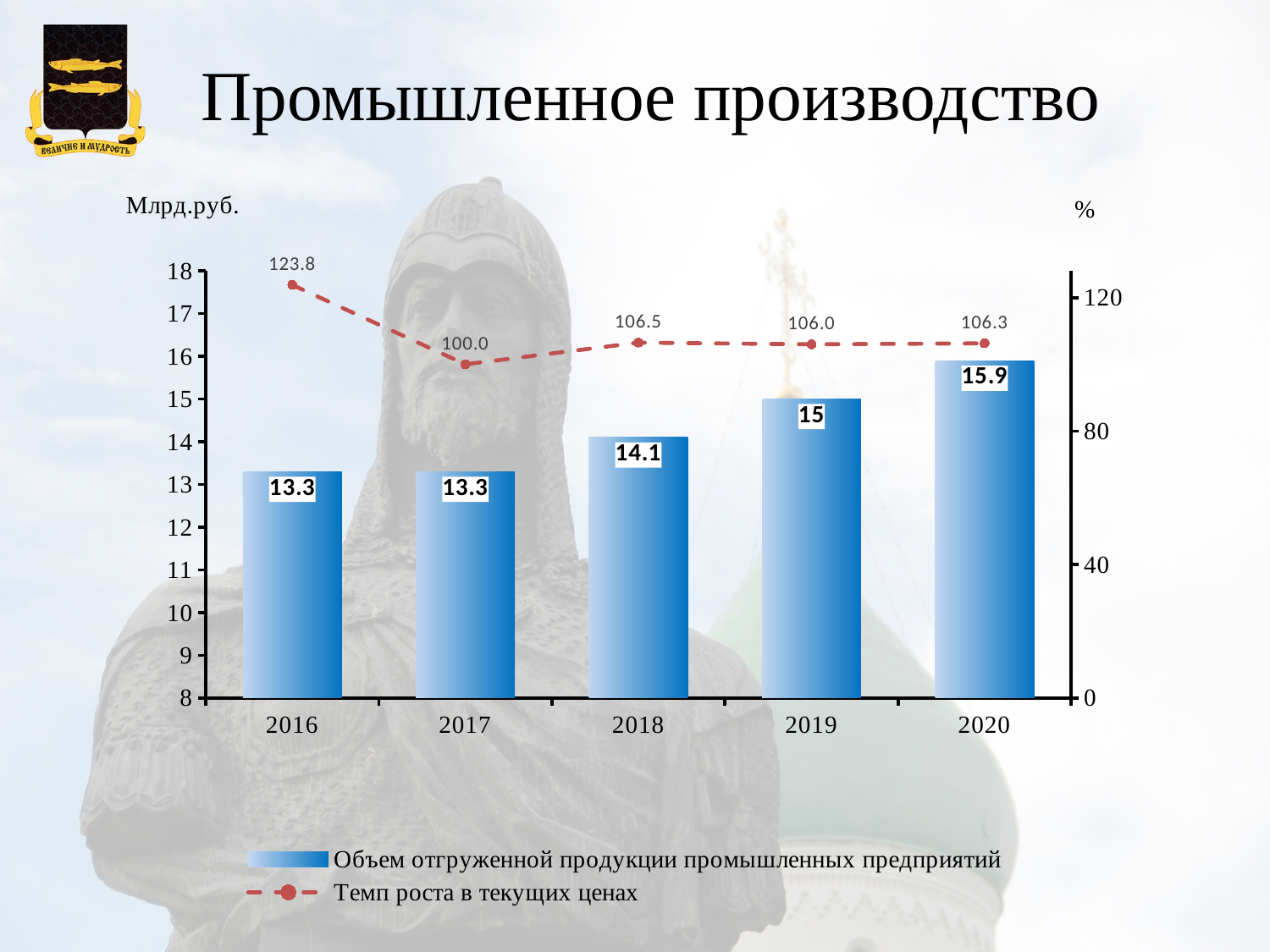
How many series does the legend list? 2 How many years are shown on the x axis? 5 What kind of chart is used for 'Объем отгруженной продукции промышленных предприятий'? bar chart What is the value of 'Темп роста в текущих ценах' for 2018? 106.5 What is the difference between the 'Объем отгруженной продукции промышленных предприятий' values for 2020 and 2016? 2.6 What is the value of 'Объем отгруженной продукции промышленных предприятий' for 2020? 15.9 Which year has the lowest value of 'Темп роста в текущих ценах'? 2017 What is the value of 'Темп роста в текущих ценах' for 2016? 123.8 Which is larger, the 'Темп роста в текущих ценах' value for 2018 or for 2019? 2018 What is the title of the slide? Промышленное производство Which year has the highest value of 'Объем отгруженной продукции промышленных предприятий'? 2020 Is the 'Темп роста в текущих ценах' value for 2016 greater or less than 120? greater